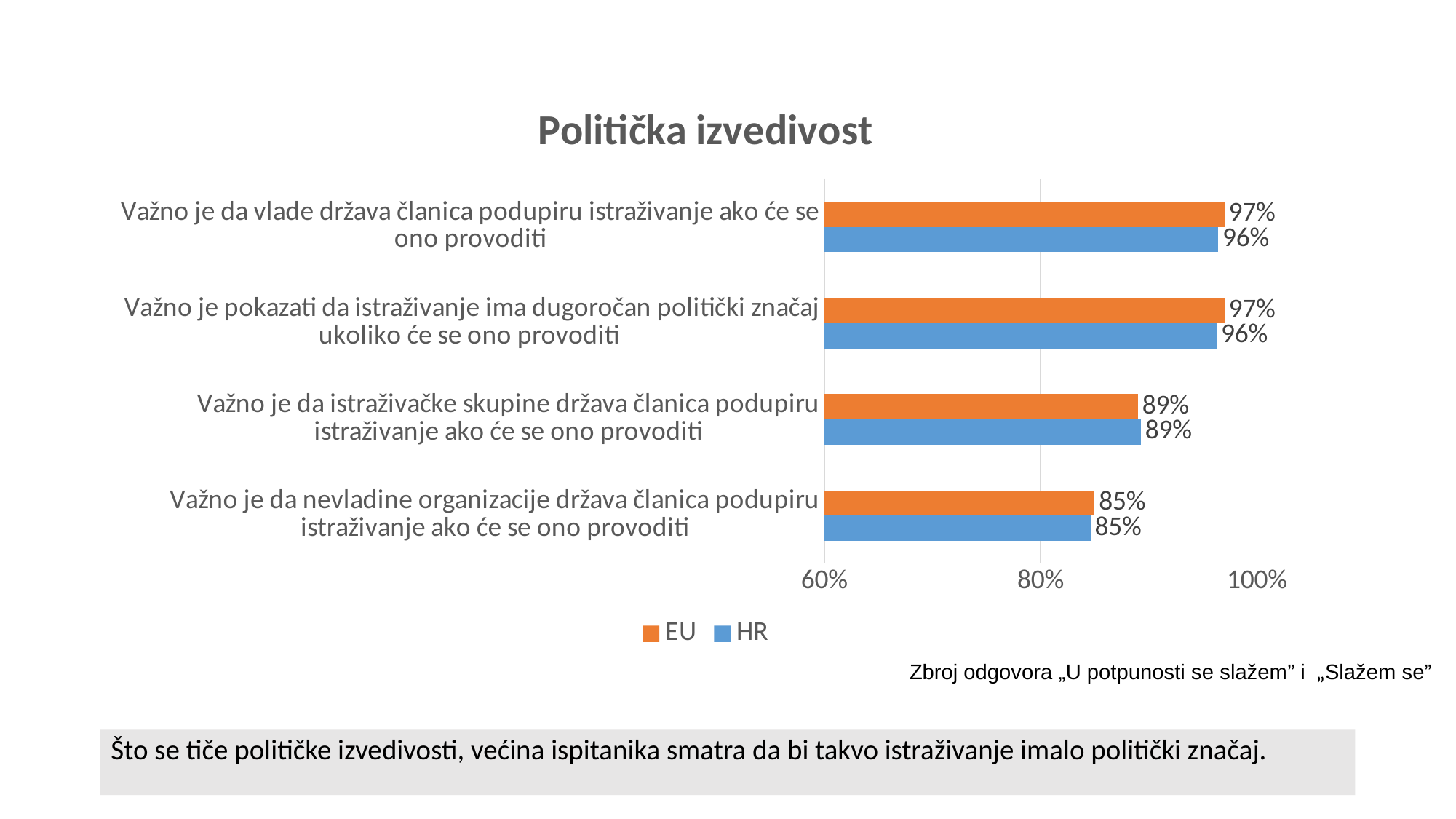
Which is larger: the HR value for "Važno je da istraživačke skupine država članica podupiru istraživanje ako će se ono provoditi" or the HR value for "Važno je da nevladine organizacije država članica podupiru istraživanje ako će se ono provoditi"? Važno je da istraživačke skupine država članica podupiru istraživanje ako će se ono provoditi What is the EU value for "Važno je da nevladine organizacije država članica podupiru istraživanje ako će se ono provoditi"? 85% Which category has the lowest EU value? Važno je da nevladine organizacije država članica podupiru istraživanje ako će se ono provoditi How many categories are shown on the chart? 4 What is the difference between the EU and HR values for "Važno je da vlade država članica podupiru istraživanje ako će se ono provoditi"? 1 percentage point What is the difference between the EU values for "Važno je da vlade država članica podupiru istraživanje ako će se ono provoditi" and "Važno je da nevladine organizacije država članica podupiru istraživanje ako će se ono provoditi"? 12 percentage points What is the EU value for "Važno je da vlade država članica podupiru istraživanje ako će se ono provoditi"? 97% How many series does the legend list? 2 What type of chart is shown on the slide? Bar chart What is the HR value for "Važno je da istraživačke skupine država članica podupiru istraživanje ako će se ono provoditi"? 89% Is the EU value for "Važno je da nevladine organizacije država članica podupiru istraživanje ako će se ono provoditi" greater or less than 80%? greater What is the HR value for "Važno je pokazati da istraživanje ima dugoročan politički značaj ukoliko će se ono provoditi"? 96%